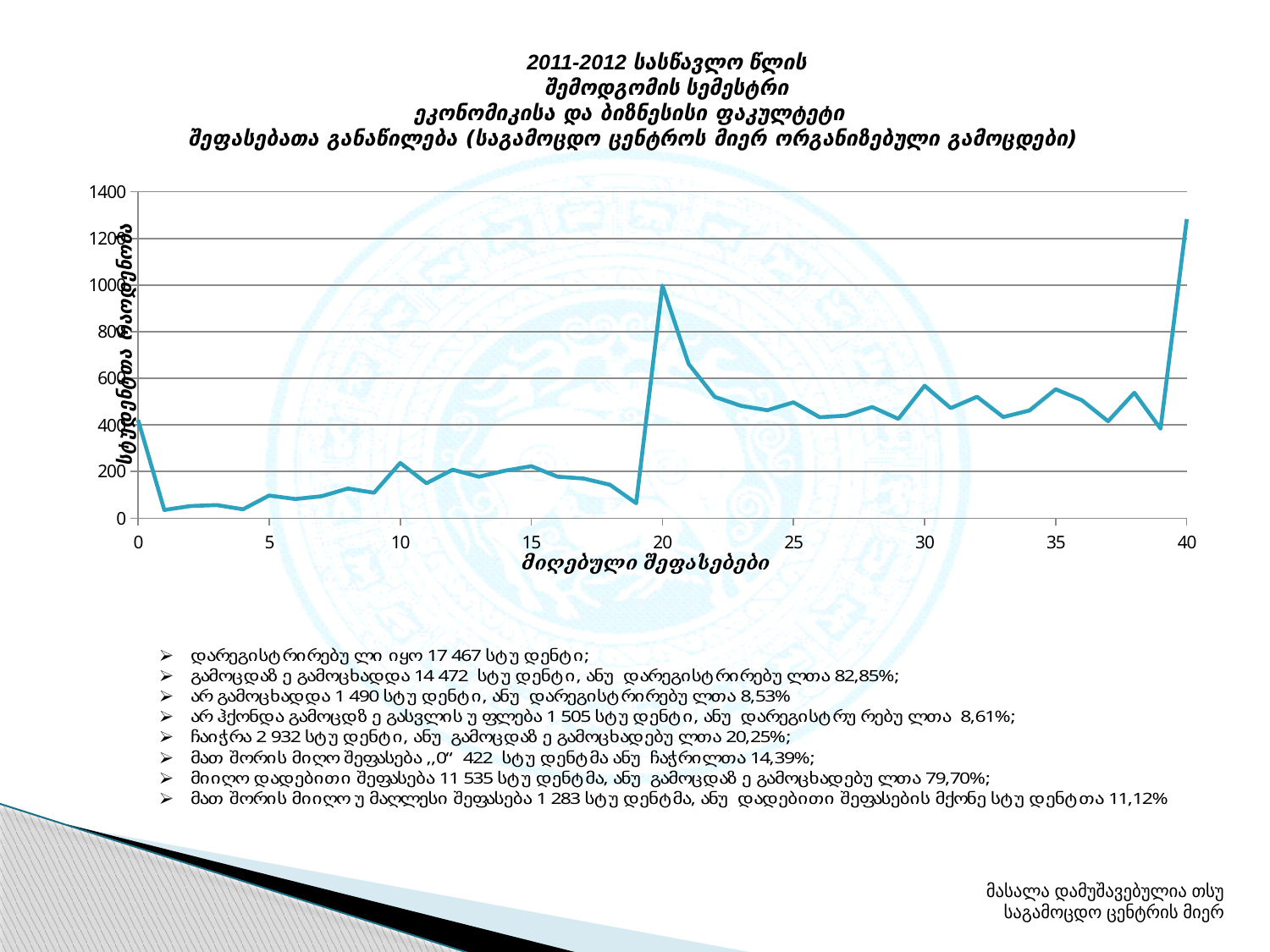
Which has the larger value, x = 40 or x = 20? x = 40 Is the value at x = 19 greater or less than 200? less Do the values rise or fall between x = 20 and x = 22? fall At which x-axis value (score) does the line reach its highest point? 40 What is the label of the x axis? მიღებული შეფასებები Is the value at x = 10 greater or less than 400? less What is the highest value labelled on the y axis? 1400 Is the value at x = 40 greater or less than 1200? greater What kind of chart is shown on the slide? line chart Which has the larger value, x = 20 or x = 10? x = 20